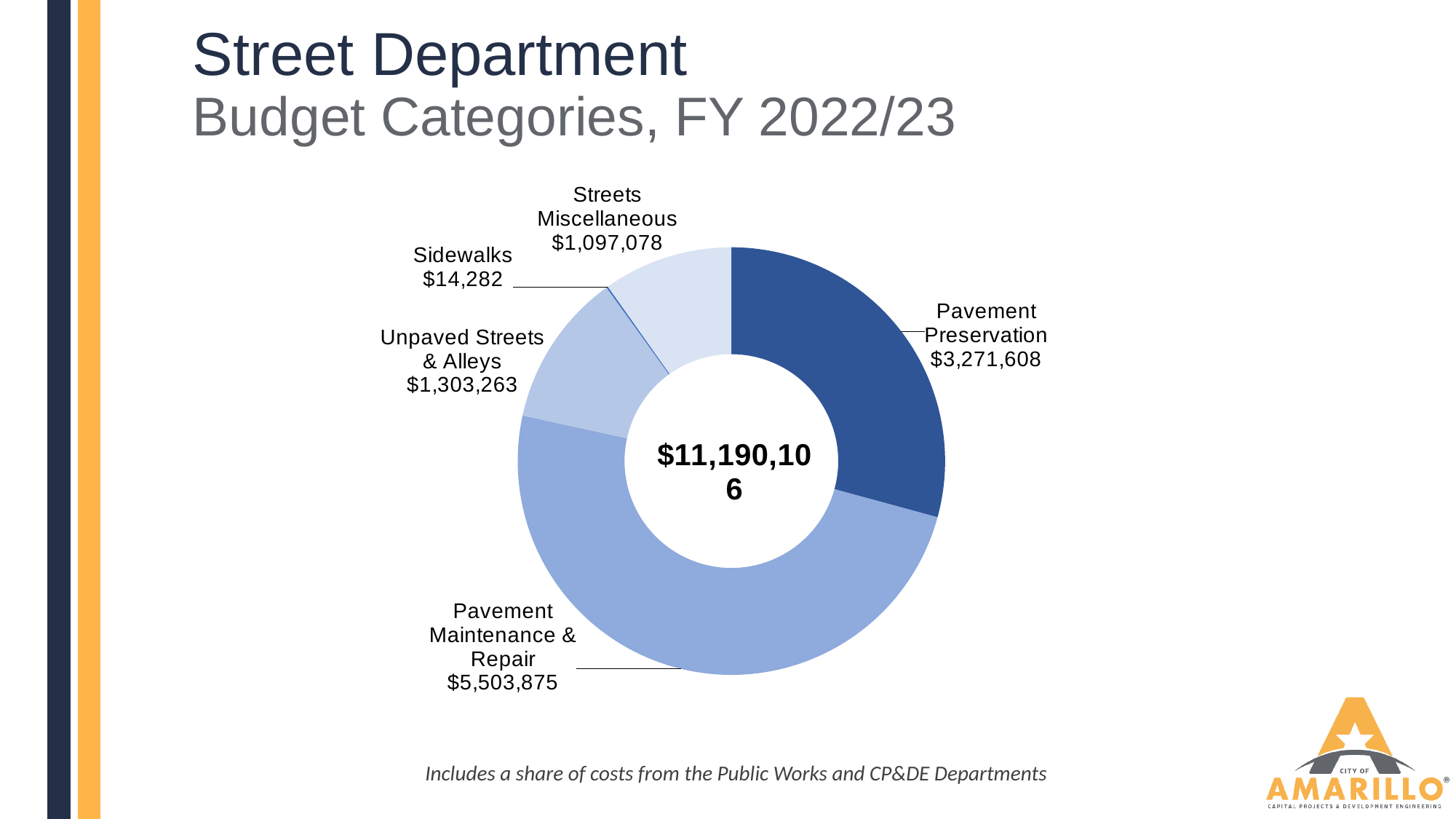
What is the budget value for Pavement Preservation? $3,271,608 What is the difference between Pavement Maintenance & Repair and Pavement Preservation? $2,232,267 What is the budget value for Unpaved Streets & Alleys? $1,303,263 Which budget category has the smallest value? Sidewalks What is the difference between Unpaved Streets & Alleys and Streets Miscellaneous? $206,185 What is the total budget shown in the center of the chart? $11,190,106 How many budget categories are shown in the chart? 5 Which is larger, Unpaved Streets & Alleys or Streets Miscellaneous? Unpaved Streets & Alleys What is the budget value for Sidewalks? $14,282 What is the budget value for Pavement Maintenance & Repair? $5,503,875 What is the budget value for Streets Miscellaneous? $1,097,078 Which budget category has the largest value? Pavement Maintenance & Repair